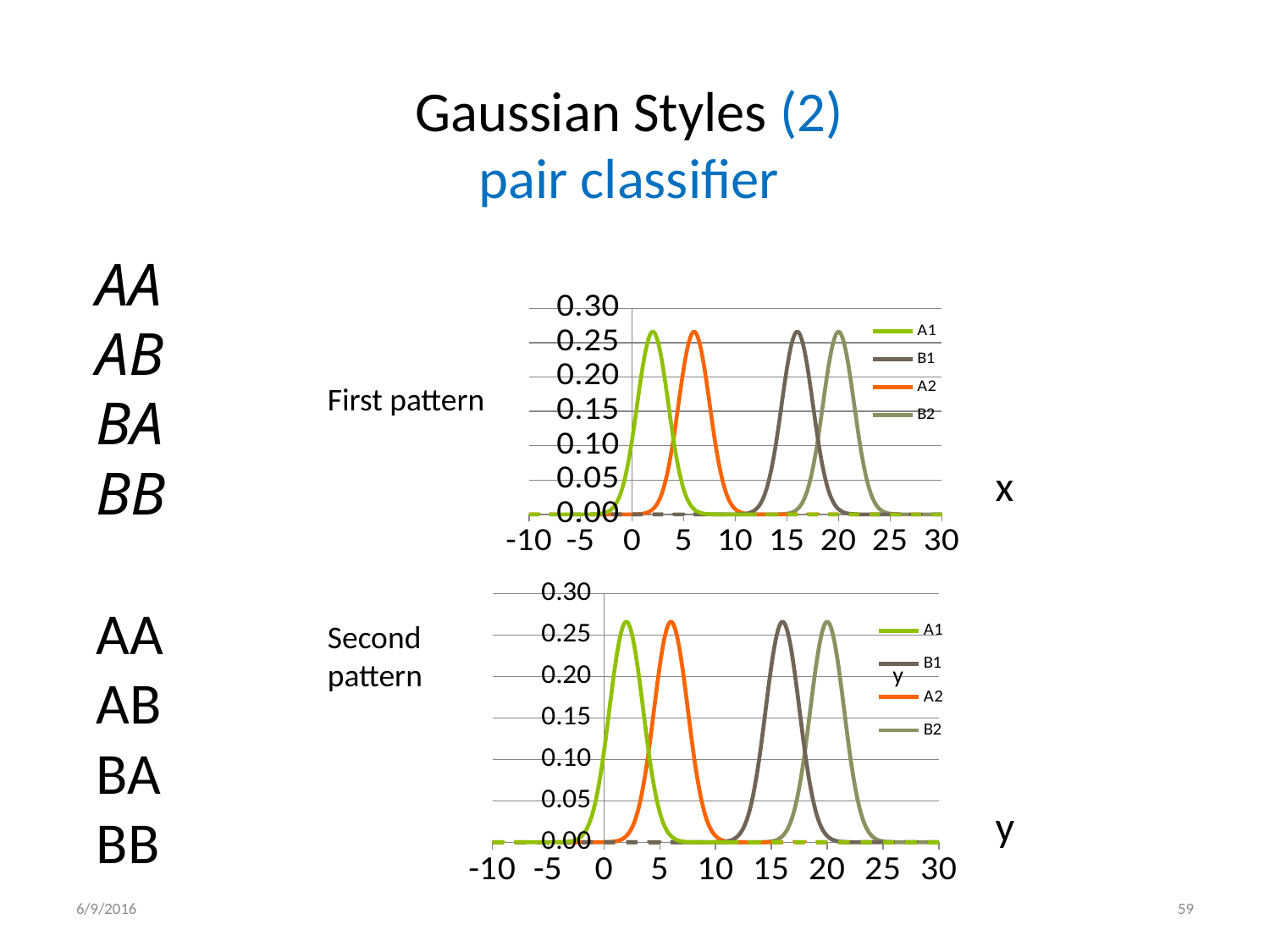
What are the series names listed in the legend of the 'First pattern' chart? A1, B1, A2, B2 In the 'Second pattern' chart, is the peak value of A1 greater or less than 0.20? greater In the 'Second pattern' chart, is the value of A2 at 20 on the horizontal axis greater or less than 0.05? less In the 'First pattern' chart, which series has its peak furthest to the left along the x axis? A1 How many series does the legend of the 'First pattern' chart list? 4 In the 'First pattern' chart, which series has its peak furthest to the right along the x axis? B2 In the 'Second pattern' chart, which series peaks closer to 15 on the horizontal axis, B1 or B2? B1 In the 'First pattern' chart, is the peak value of B1 greater or less than 0.30? less What colour is the A2 line in the 'Second pattern' chart? orange What kind of chart is the 'First pattern' chart? line chart How many series does the legend of the 'Second pattern' chart list? 4